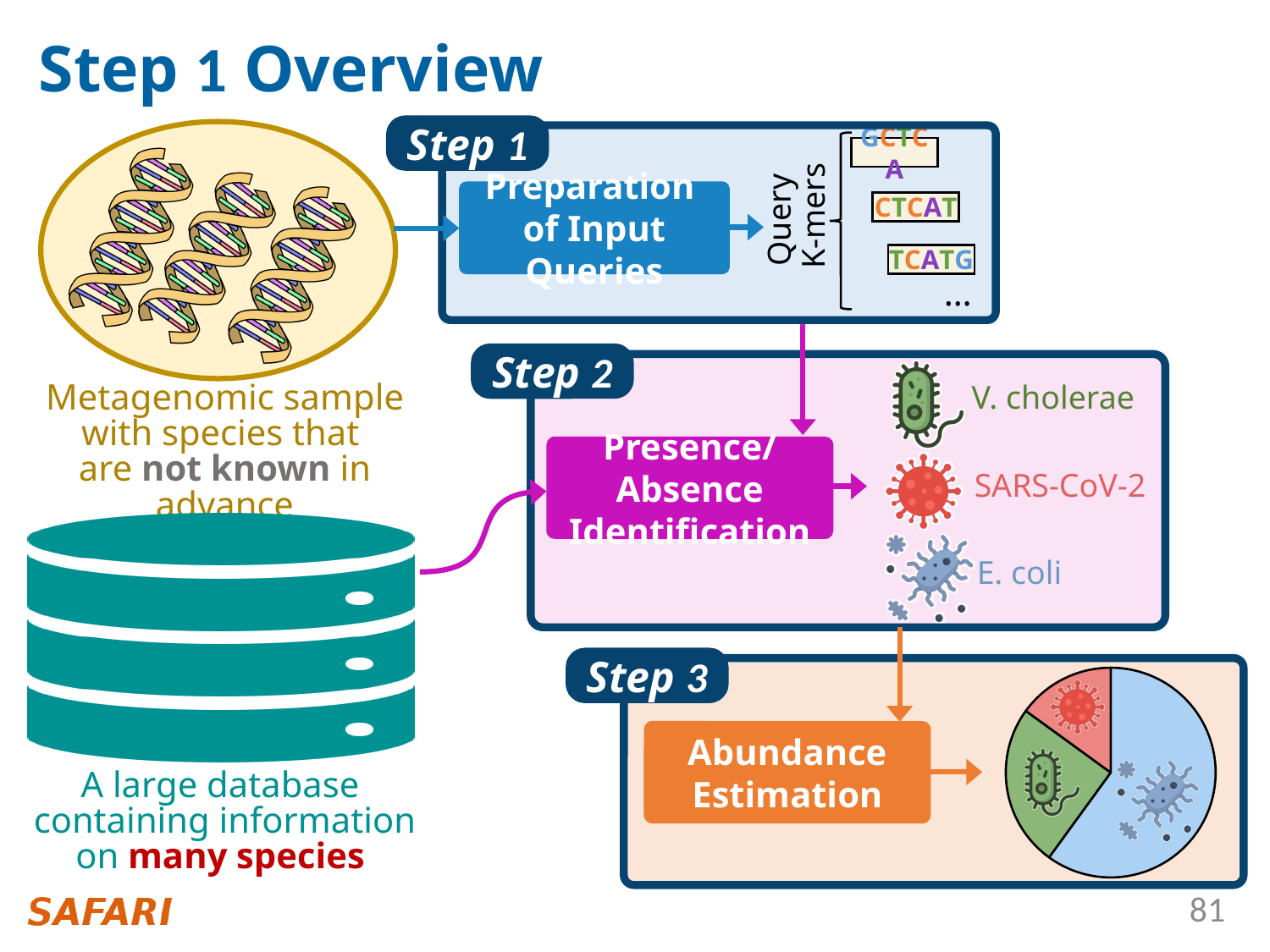
What kind of chart is shown in the Step 3 box? pie chart Which species icon appears in the largest slice of the Step 3 pie chart? E. coli How many slices does the pie chart in the Step 3 box have? 3 In the Step 3 pie chart, which slice is the smallest: the blue, green or red one? red Which species icon appears in the red slice of the Step 3 pie chart? SARS-CoV-2 In the Step 3 pie chart, is the blue slice larger or smaller than the green slice? larger In the Step 3 pie chart, is the green slice larger or smaller than the red slice? larger In the Step 3 pie chart, which slice is the largest: the blue, green or red one? blue